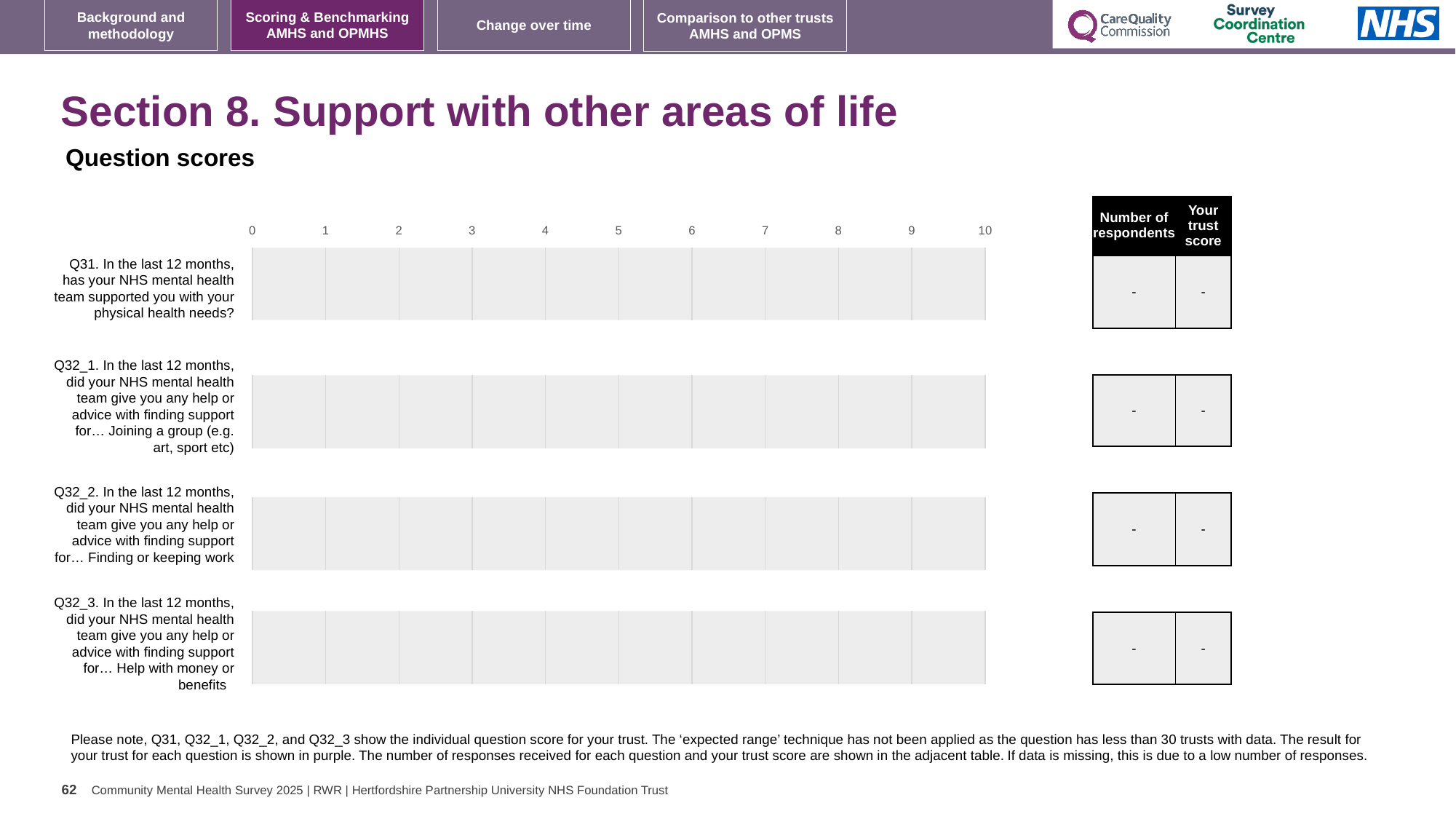
Which question label appears first (at the top) of the chart? Q31 What kind of chart is shown on the slide? bar chart What is the 'Your trust score' shown in the table for Q31? - What is the lowest value shown on the chart's axis? 0 How many questions (categories) are listed on the chart? 4 What is the highest value shown on the chart's axis? 10 What is the 'Number of respondents' shown in the table for Q32_2? - What is the 'Number of respondents' shown in the table for Q32_1? - What is the 'Your trust score' shown in the table for Q32_3? -